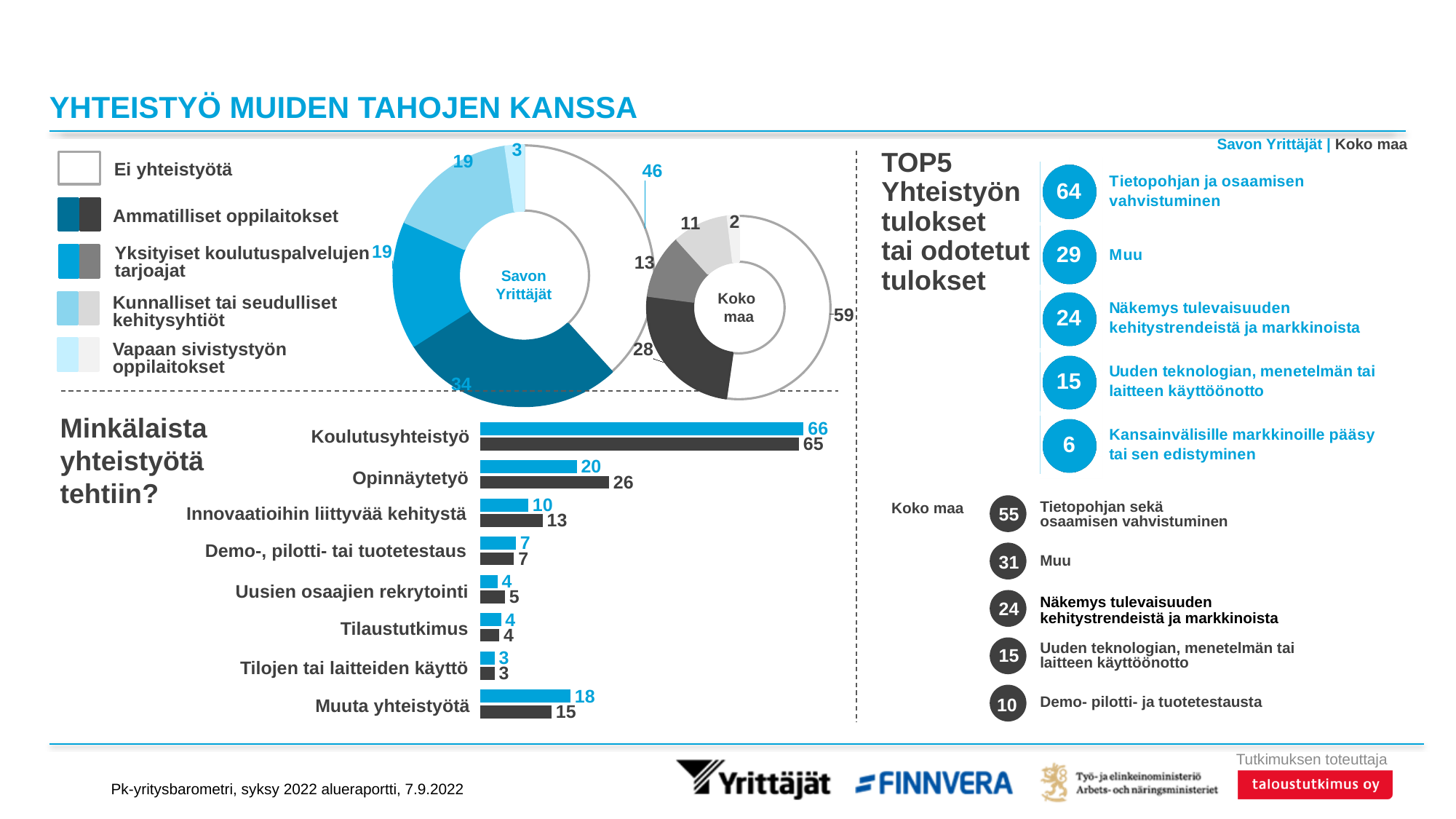
In the bar chart 'Minkälaista yhteistyötä tehtiin?', what is the Koko maa value for Opinnäytetyö? 26 In the bar chart 'Minkälaista yhteistyötä tehtiin?', what is the Savon Yrittäjät value for Koulutusyhteistyö? 66 How many segments does the Koko maa donut chart have? 5 In the Koko maa donut chart, what is the value for Ammatilliset oppilaitokset? 28 In the bar chart 'Minkälaista yhteistyötä tehtiin?', which is larger for Muuta yhteistyötä: the Savon Yrittäjät value or the Koko maa value? Savon Yrittäjät What type of chart is 'Minkälaista yhteistyötä tehtiin?'? bar chart In the Savon Yrittäjät donut chart, what is the value for Ei yhteistyötä? 46 In the bar chart 'Minkälaista yhteistyötä tehtiin?', which category has the highest Savon Yrittäjät value? Koulutusyhteistyö In the Savon Yrittäjät donut chart, which segment is the smallest? Vapaan sivistystyön oppilaitokset In the bar chart 'Minkälaista yhteistyötä tehtiin?', which category has the lowest Koko maa value? Tilojen tai laitteiden käyttö How many categories does the bar chart 'Minkälaista yhteistyötä tehtiin?' show? 8 In the bar chart 'Minkälaista yhteistyötä tehtiin?', what is the difference between the Koko maa and Savon Yrittäjät values for Opinnäytetyö? 6